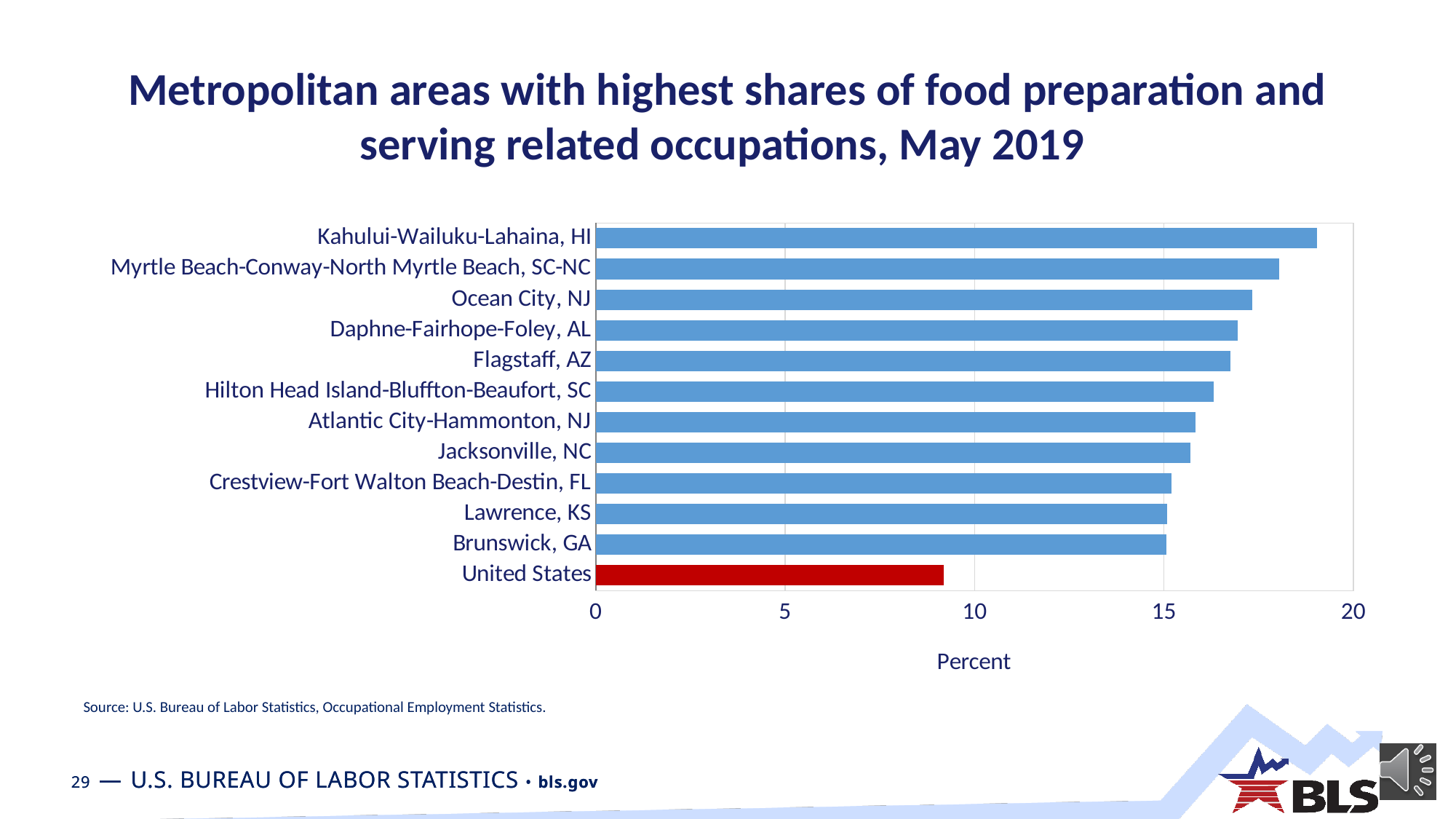
What colour is the bar for United States? red What kind of chart is shown on the slide? bar chart How many categories (bars) are shown in the chart? 12 Is the value for Ocean City, NJ greater or less than 15? greater Is the value for Hilton Head Island-Bluffton-Beaufort, SC greater or less than 20? less Which metropolitan area has the highest share of food preparation and serving related occupations? Kahului-Wailuku-Lahaina, HI Is the value for United States greater or less than 10? less Which has a larger value, Ocean City, NJ or Hilton Head Island-Bluffton-Beaufort, SC? Ocean City, NJ Which has a larger value, Kahului-Wailuku-Lahaina, HI or Myrtle Beach-Conway-North Myrtle Beach, SC-NC? Kahului-Wailuku-Lahaina, HI What is the label of the horizontal axis? Percent Which category has the lowest value in the chart? United States